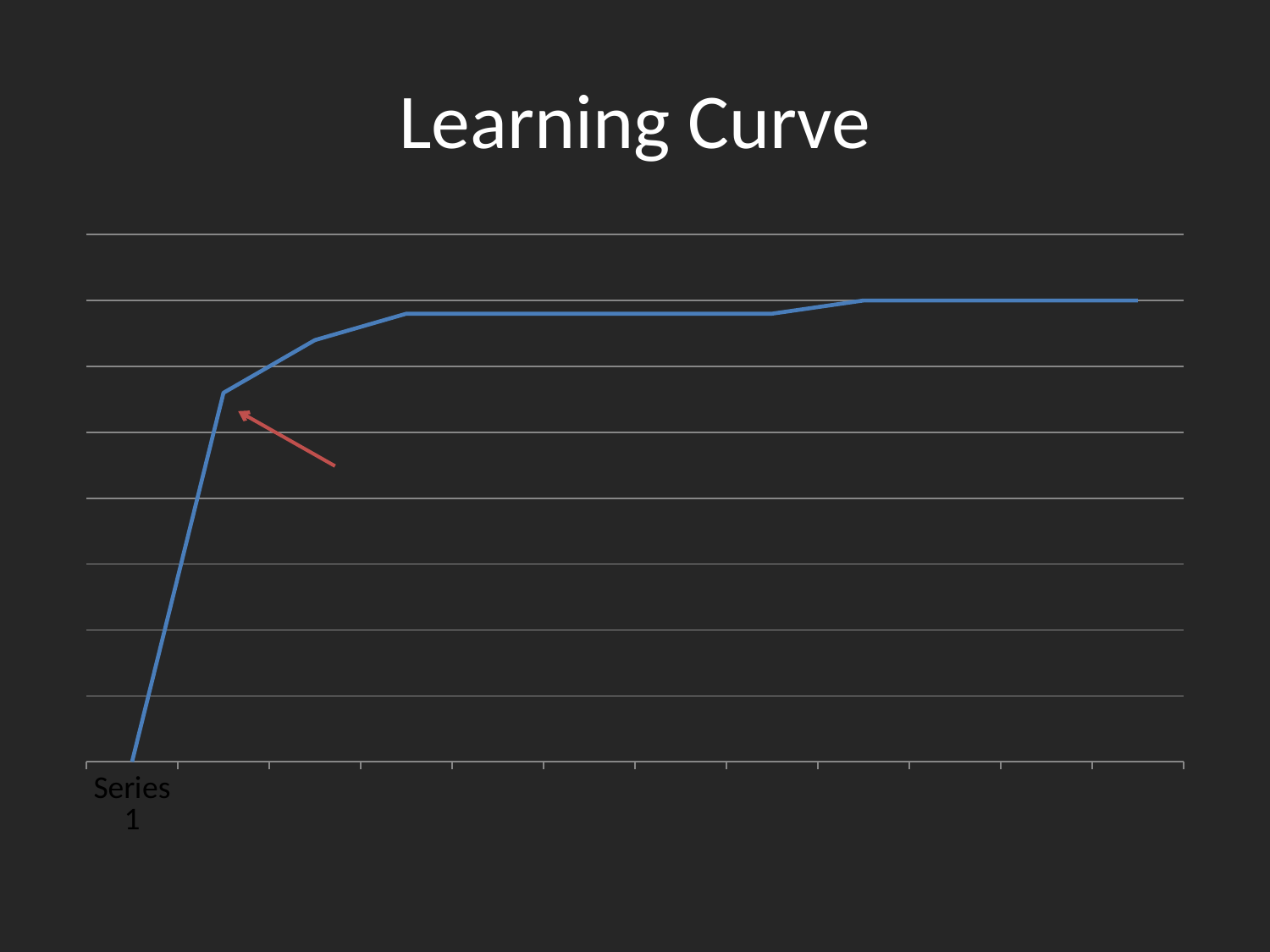
What is the title of the chart on the slide? Learning Curve Do the values on the Learning Curve chart rise or fall along the x axis? rise What kind of chart is shown on the slide? line chart What colour is the plotted line on the Learning Curve chart? blue